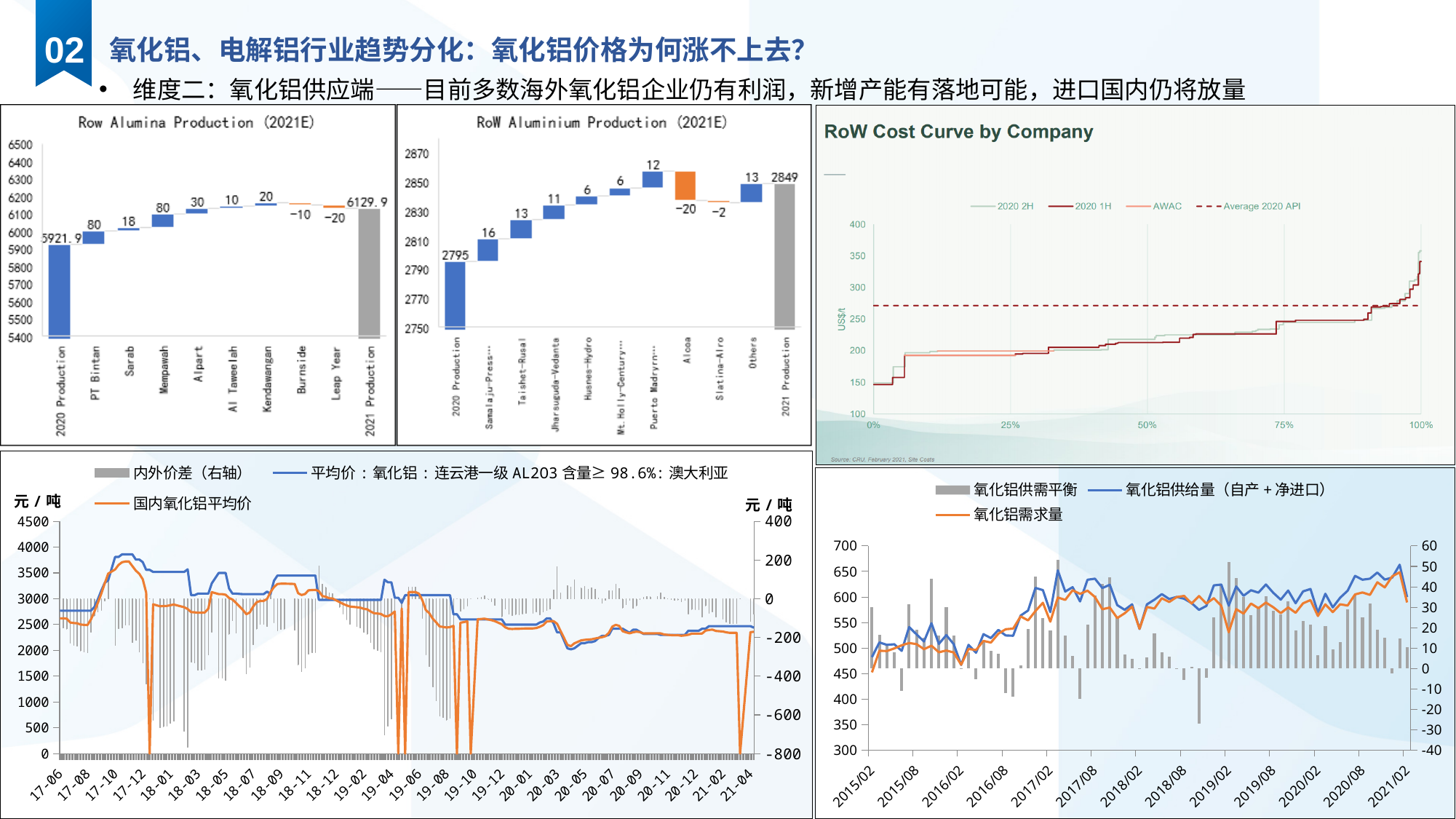
In the bottom-left chart, how many series does the legend list? 3 In the RoW Cost Curve by Company chart, is the Average 2020 API dashed line greater or less than 250 US$/t? greater In the Row Alumina Production (2021E) chart, how many categories are shown on the x axis? 10 In the Row Alumina Production (2021E) chart, what is the value shown for 2021 Production? 6129.9 In the RoW Aluminium Production (2021E) chart, which is larger, the value for Taishet-Rusal or for Jharsuguda-Vedanta? Taishet-Rusal In the Row Alumina Production (2021E) chart, what is the difference between the 2021 Production and 2020 Production values? 208 In the RoW Aluminium Production (2021E) chart, which company has the largest positive change? Samalaju-Press… In the RoW Aluminium Production (2021E) chart, what is the value labelled for Alcoa? -20 In the Row Alumina Production (2021E) chart, what is the value labelled for Leap Year? -20 In the RoW Cost Curve by Company chart, how many series does the legend list? 4 In the RoW Aluminium Production (2021E) chart, what is the value shown for 2021 Production? 2849 In the Row Alumina Production (2021E) chart, what is the value shown for 2020 Production? 5921.9